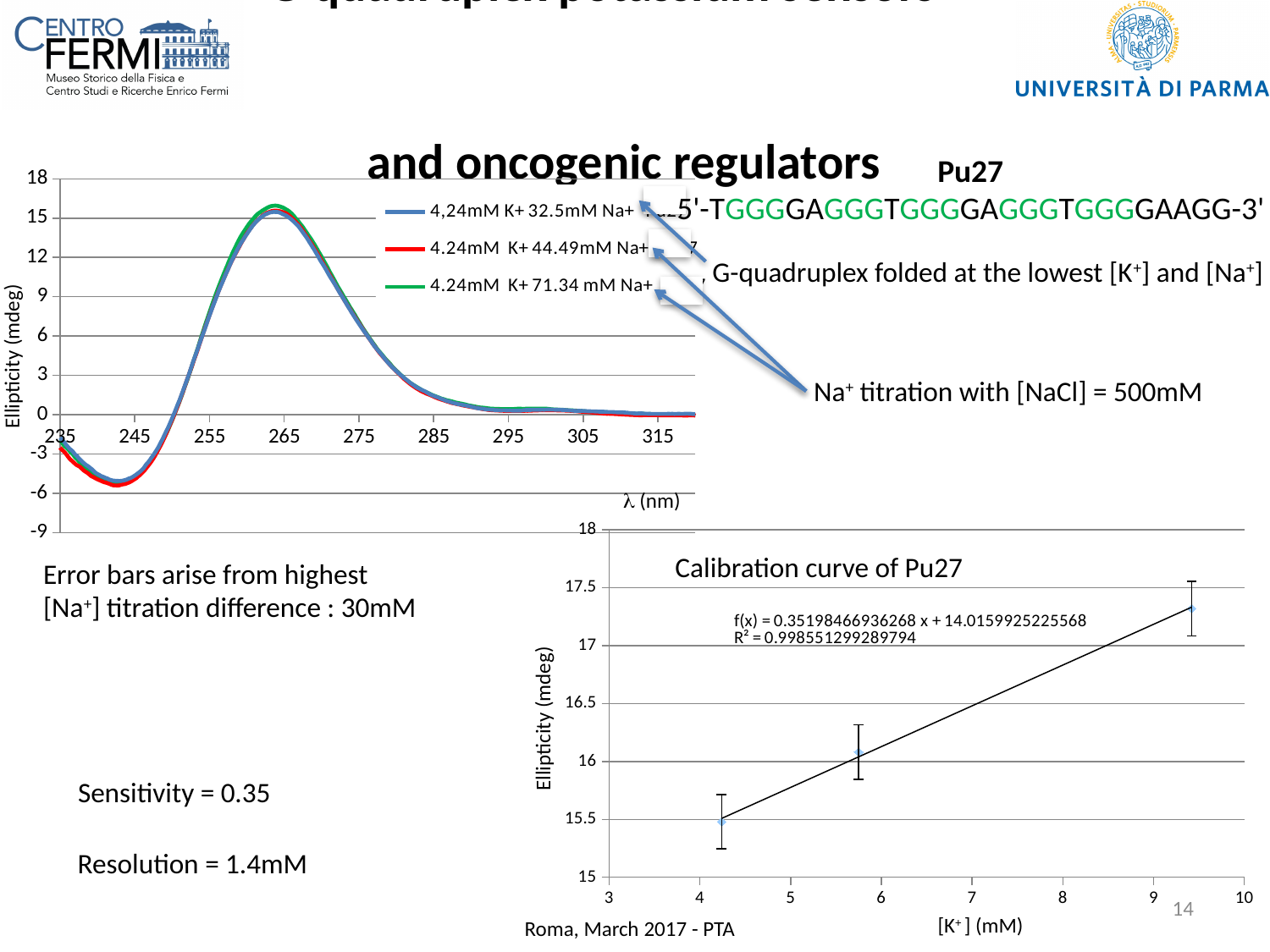
In the top-left ellipticity chart, is the minimum ellipticity near 245 nm greater or less than -3? less In the Calibration curve of Pu27 chart, what is the R² value shown for the fitted line? 0.998551299289794 What is the title of the bottom-right chart? Calibration curve of Pu27 In the top-left ellipticity chart, what is the label of the y axis? Ellipticity (mdeg) In the Calibration curve of Pu27 chart, does ellipticity rise or fall as [K+] increases? rise In the Calibration curve of Pu27 chart, is the ellipticity of the point at the highest [K+] greater or less than 17? greater In the top-left ellipticity chart, do the curves rise or fall between 245 nm and 265 nm? rise What kind of chart is the top-left chart showing ellipticity versus wavelength? line chart In the top-left ellipticity chart, is the peak ellipticity near 265 nm greater or less than 12? greater In the top-left ellipticity chart, what is the label of the x axis? λ (nm) How many data points are plotted in the Calibration curve of Pu27 chart? 3 How many series does the legend of the top-left ellipticity chart list? 3